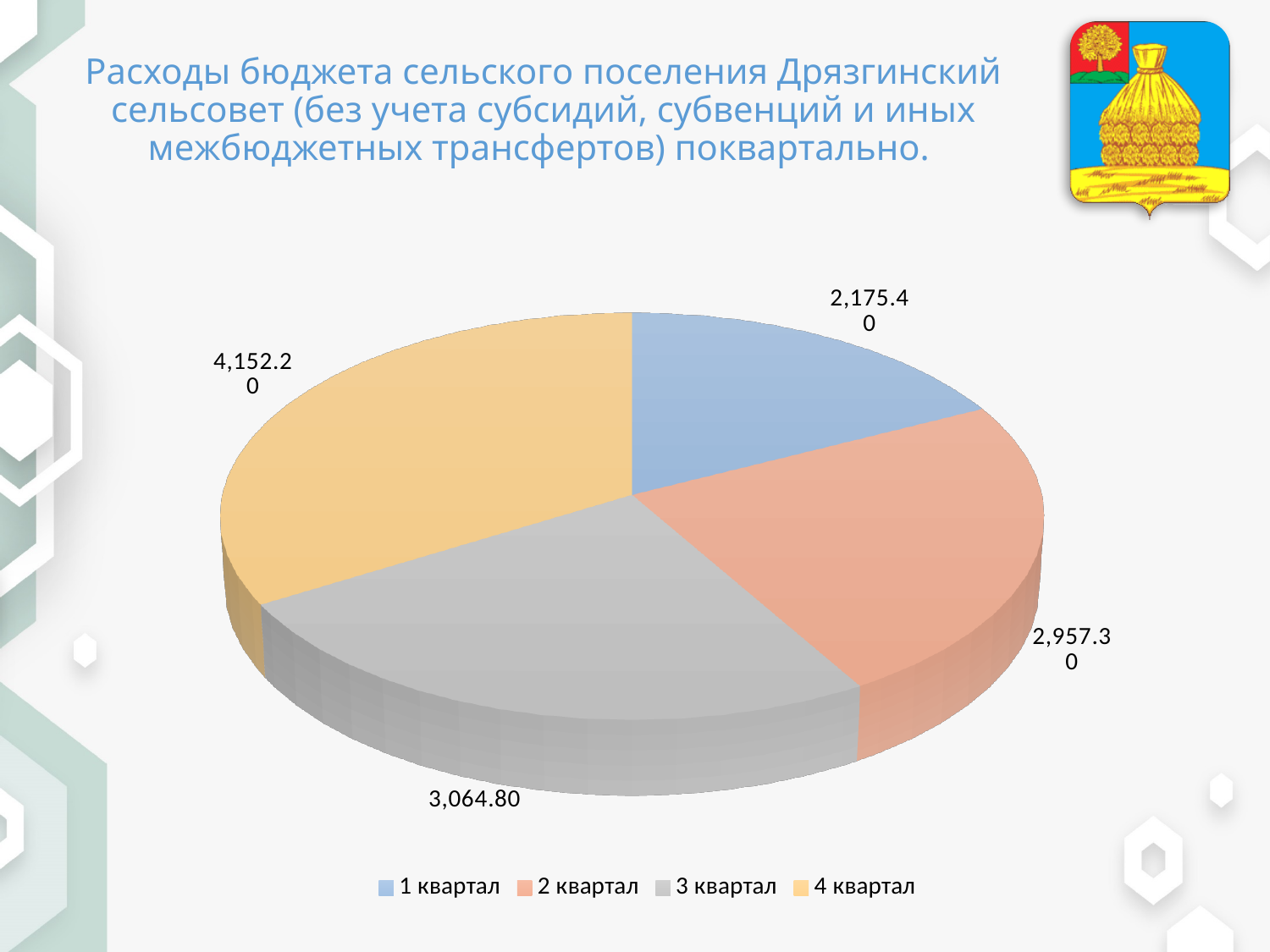
Which quarter has the largest slice of the pie? 4 квартал What is the value for 1 квартал? 2,175.40 Which is larger, the value for 2 квартал or the value for 3 квартал? 3 квартал How many slices does the pie chart have? 4 What type of chart is shown on the slide? pie chart What is the value for 4 квартал? 4,152.20 What is the difference between the values for 3 квартал and 2 квартал? 107.50 What is the value for 2 квартал? 2,957.30 What colour is the slice for 4 квартал? yellow Which quarter has the smallest slice of the pie? 1 квартал What is the value for 3 квартал? 3,064.80 What is the difference between the values for 4 квартал and 1 квартал? 1,976.80